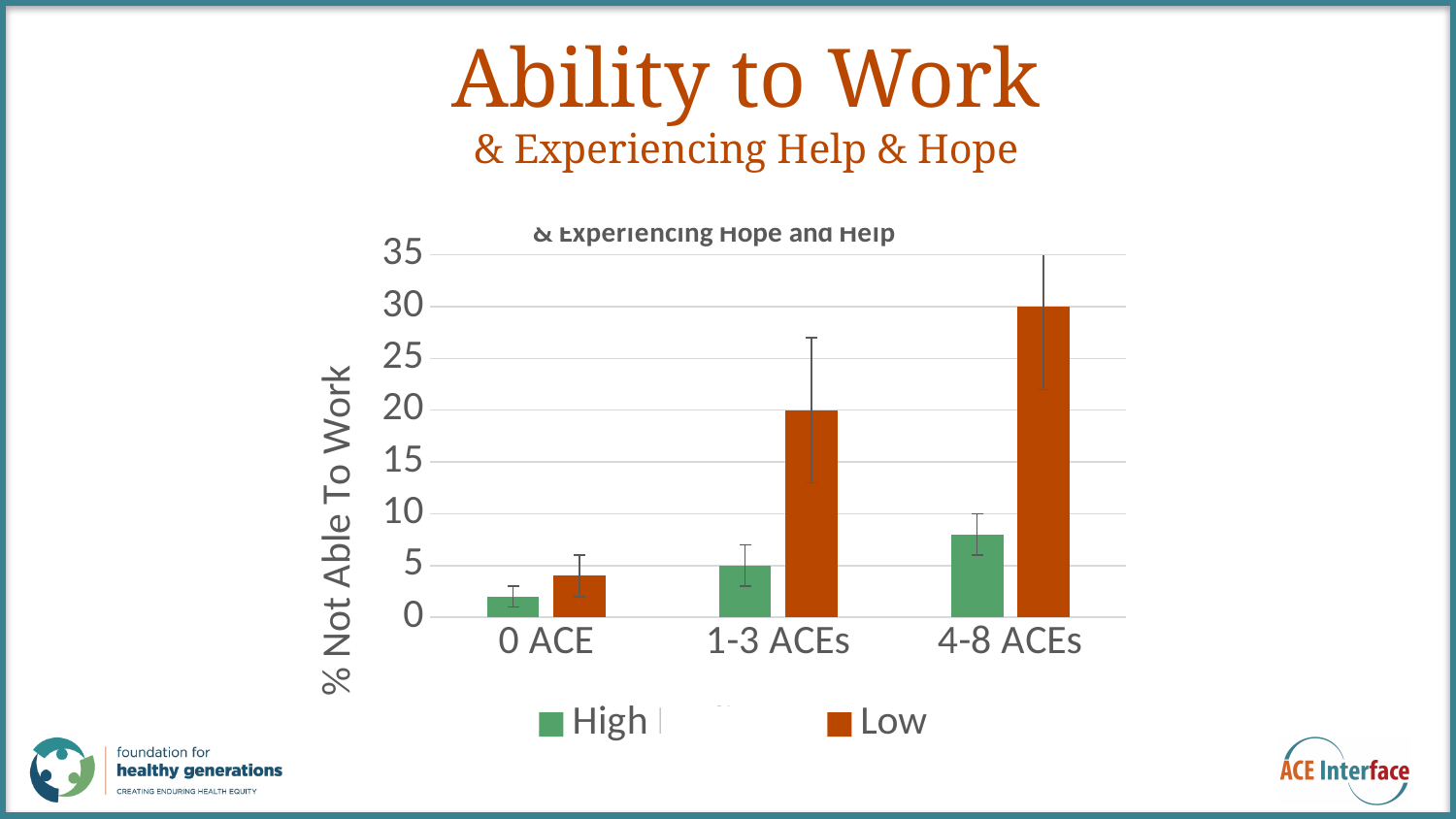
What is the value of the High series for 1-3 ACEs? 5 Is the value of the Low series for 0 ACE greater or less than 5? less What is the y-axis label of the chart? % Not Able To Work Which category has the lowest value for the High series? 0 ACE How many series does the legend list? 2 Do the values of the Low series rise or fall from 0 ACE to 4-8 ACEs? rise What is the value of the Low series for 1-3 ACEs? 20 What kind of chart is shown on the slide? bar chart Which category has the highest value for the Low series? 4-8 ACEs How many categories are shown on the x axis? 3 Is the value of the High series for 4-8 ACEs greater or less than 10? less What is the value of the Low series for 4-8 ACEs? 30